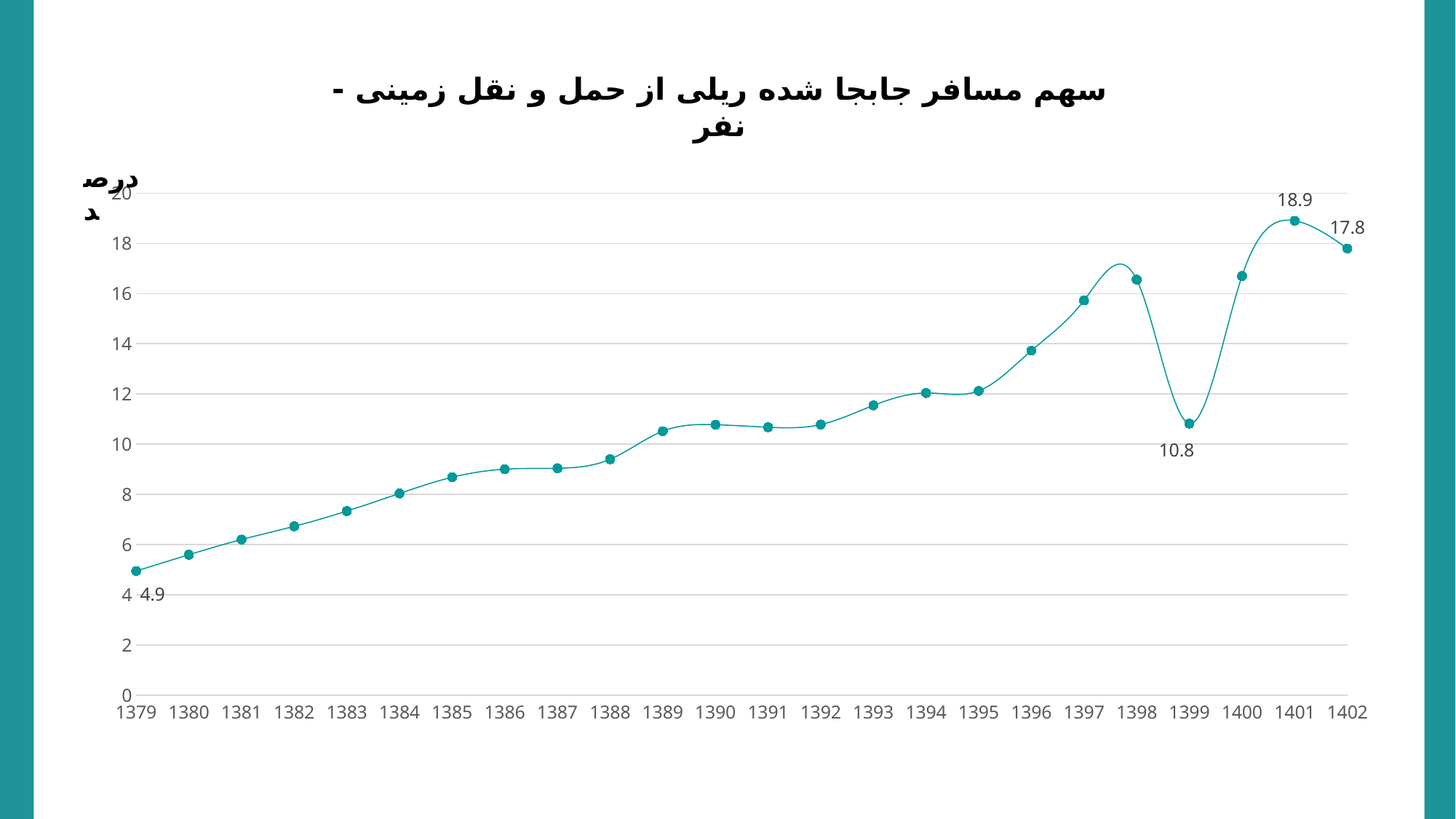
What is the value for 1402? 17.8 Which year has the highest value? 1401 What is the difference between the values for 1401 and 1402? 1.1 What is the difference between the values for 1401 and 1399? 8.1 Which year has the lowest value? 1379 What is the value for 1379? 4.9 What is the value for 1399? 10.8 What is the value for 1401? 18.9 Is the value for 1397 greater or less than 14? greater What kind of chart is shown on the slide? line chart Which is larger, the value for 1401 or the value for 1402? 1401 How many years are plotted on the x axis? 24